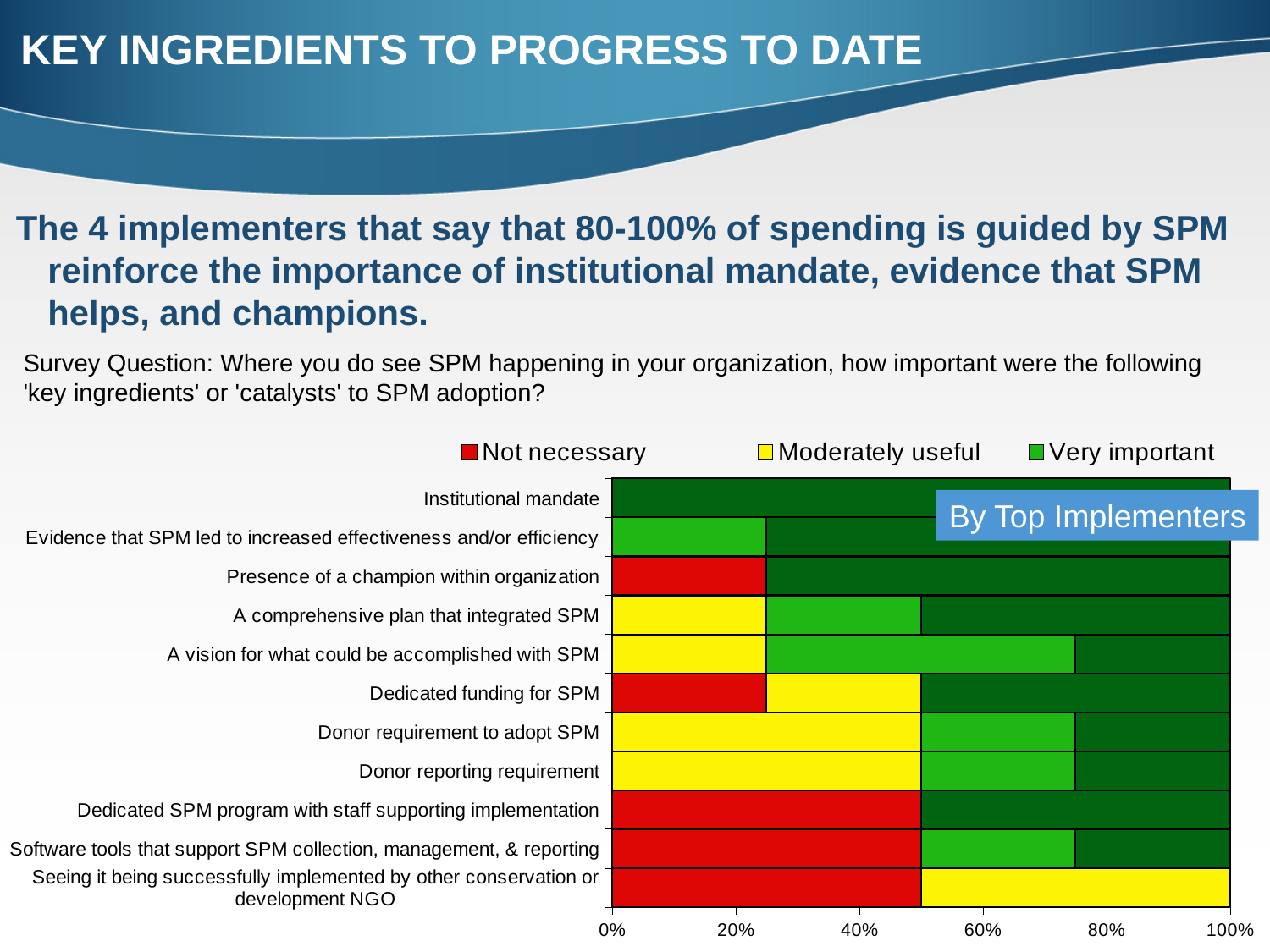
How many entries does the chart legend list? 3 Which colour represents 'Not necessary' in the chart legend? Red Is the 'Not necessary' share for 'Dedicated SPM program with staff supporting implementation' greater or less than 40%? greater Is the 'Not necessary' share for 'Dedicated funding for SPM' greater or less than 40%? less Is the 'Moderately useful' share for 'A comprehensive plan that integrated SPM' greater or less than 40%? less Which category is listed at the top of the chart? Institutional mandate What kind of chart is shown on the slide? Bar chart How many 'key ingredient' categories are plotted in the chart? 11 Which has the larger 'Not necessary' share: 'Dedicated funding for SPM' or 'Software tools that support SPM collection, management, & reporting'? Software tools that support SPM collection, management, & reporting